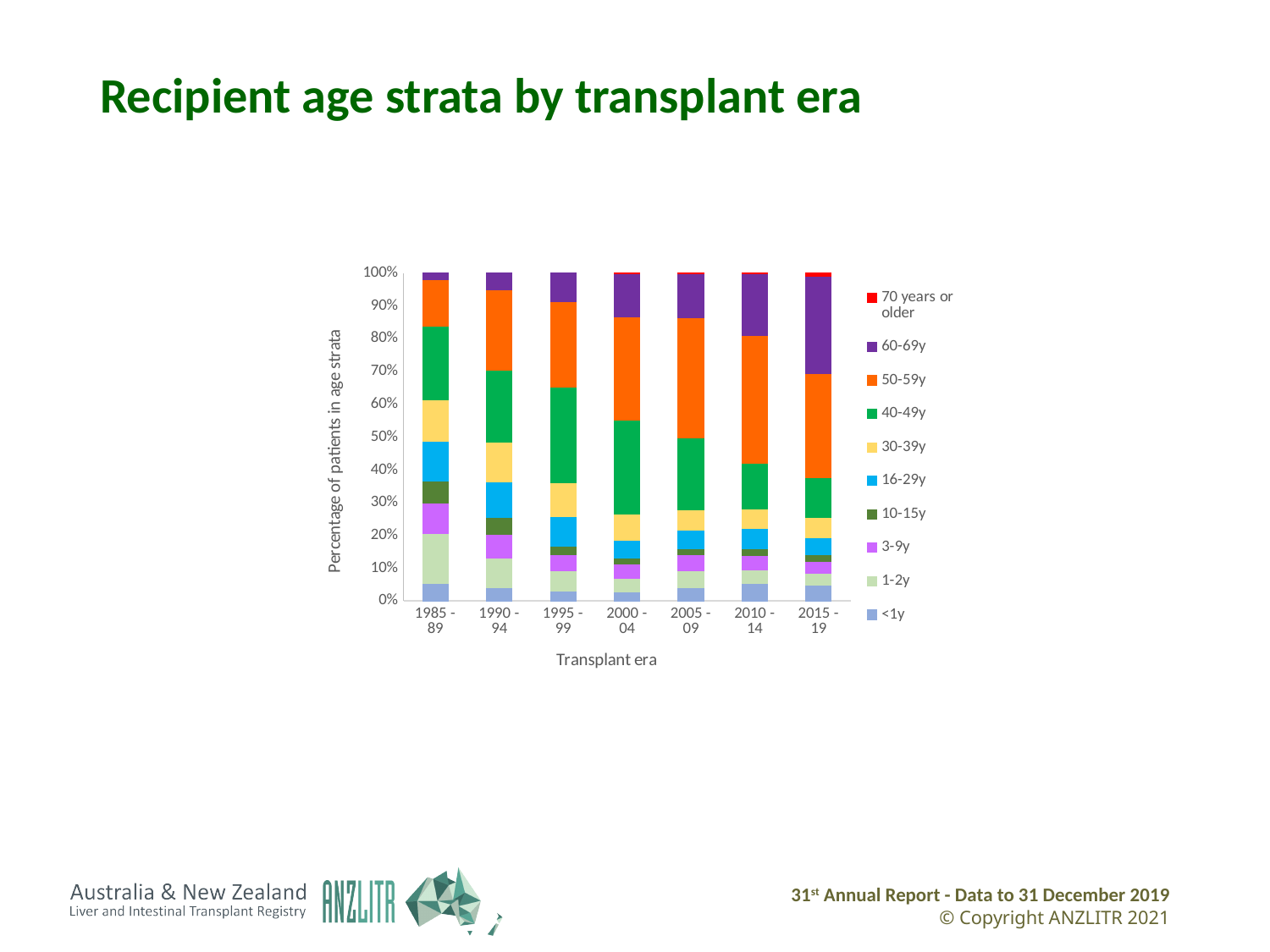
Is the share of recipients aged 40-49y larger in 1985 - 89 or in 2015 - 19? 1985 - 89 Which transplant era has the largest share of recipients aged 1-2y? 1985 - 89 How many transplant eras are shown along the x axis? 7 Is the share of recipients aged 60-69y larger in 1985 - 89 or in 2015 - 19? 2015 - 19 Which transplant era has the largest share of recipients aged 60-69y? 2015 - 19 What is the title of the chart? Recipient age strata by transplant era What is the total of the stacked bar for the 2015 - 19 transplant era? 100% What kind of chart is shown on the slide? Stacked bar chart How many age strata series does the legend list? 10 What is the label of the y axis? Percentage of patients in age strata Does the share of recipients aged 60-69y rise or fall across the transplant eras from 1985 - 89 to 2015 - 19? Rise In the 1995 - 99 era, is the cumulative percentage at the top of the 40-49y segment greater or less than 60%? greater